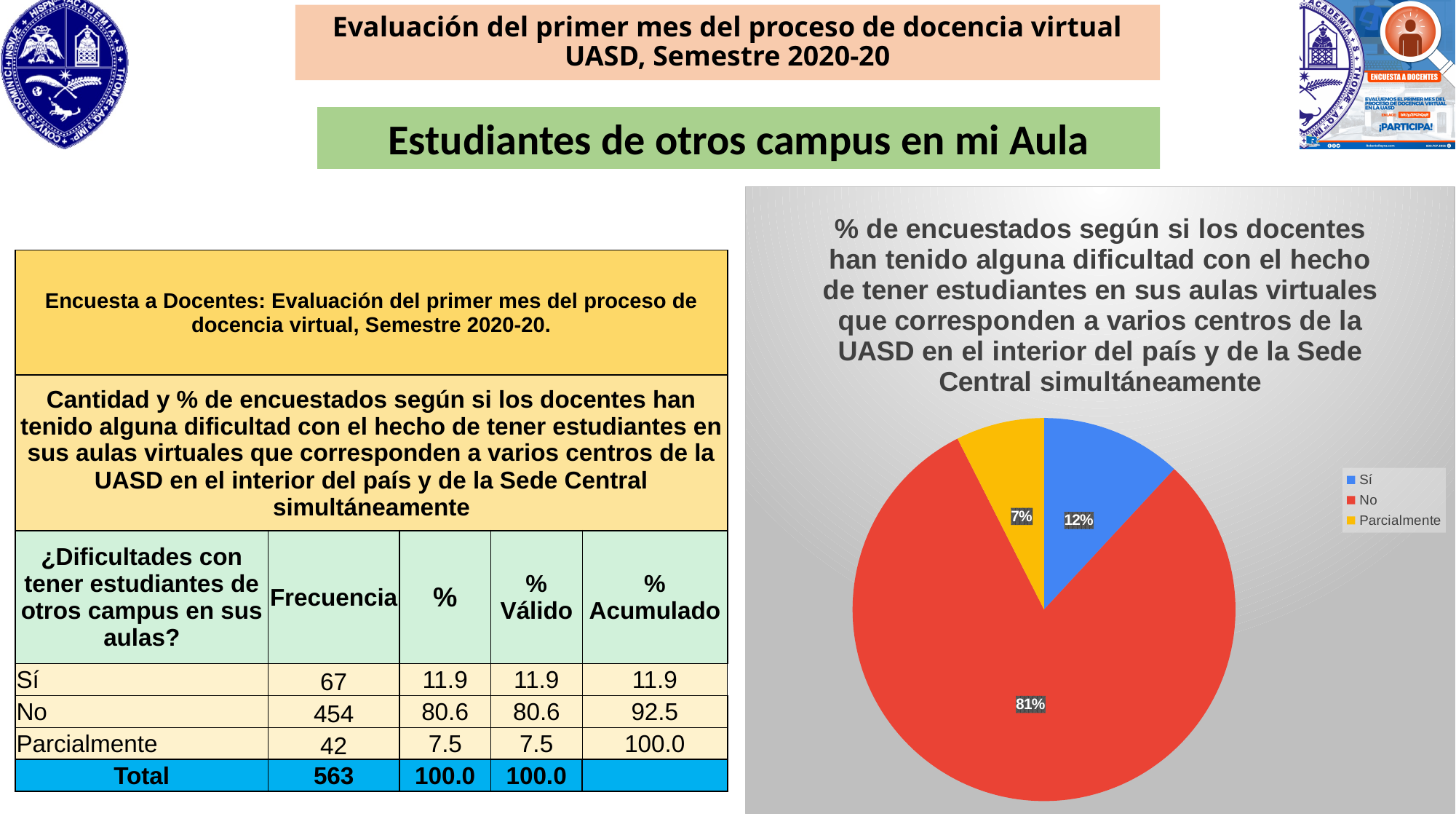
What colour is the "Parcialmente" slice in the pie chart? yellow What kind of chart is shown on the slide? pie chart Which slice is larger in the pie chart, "Sí" or "Parcialmente"? Sí What percentage does the pie chart show for "No"? 81% What colour is the "No" slice in the pie chart? red What percentage does the pie chart show for "Sí"? 12% Which category has the largest slice in the pie chart? No Which category has the smallest slice in the pie chart? Parcialmente What percentage does the pie chart show for "Parcialmente"? 7% What is the difference in percentage points between the "No" slice and the "Sí" slice in the pie chart? 69 How many entries does the pie chart's legend list? 3 How many slices does the pie chart have? 3